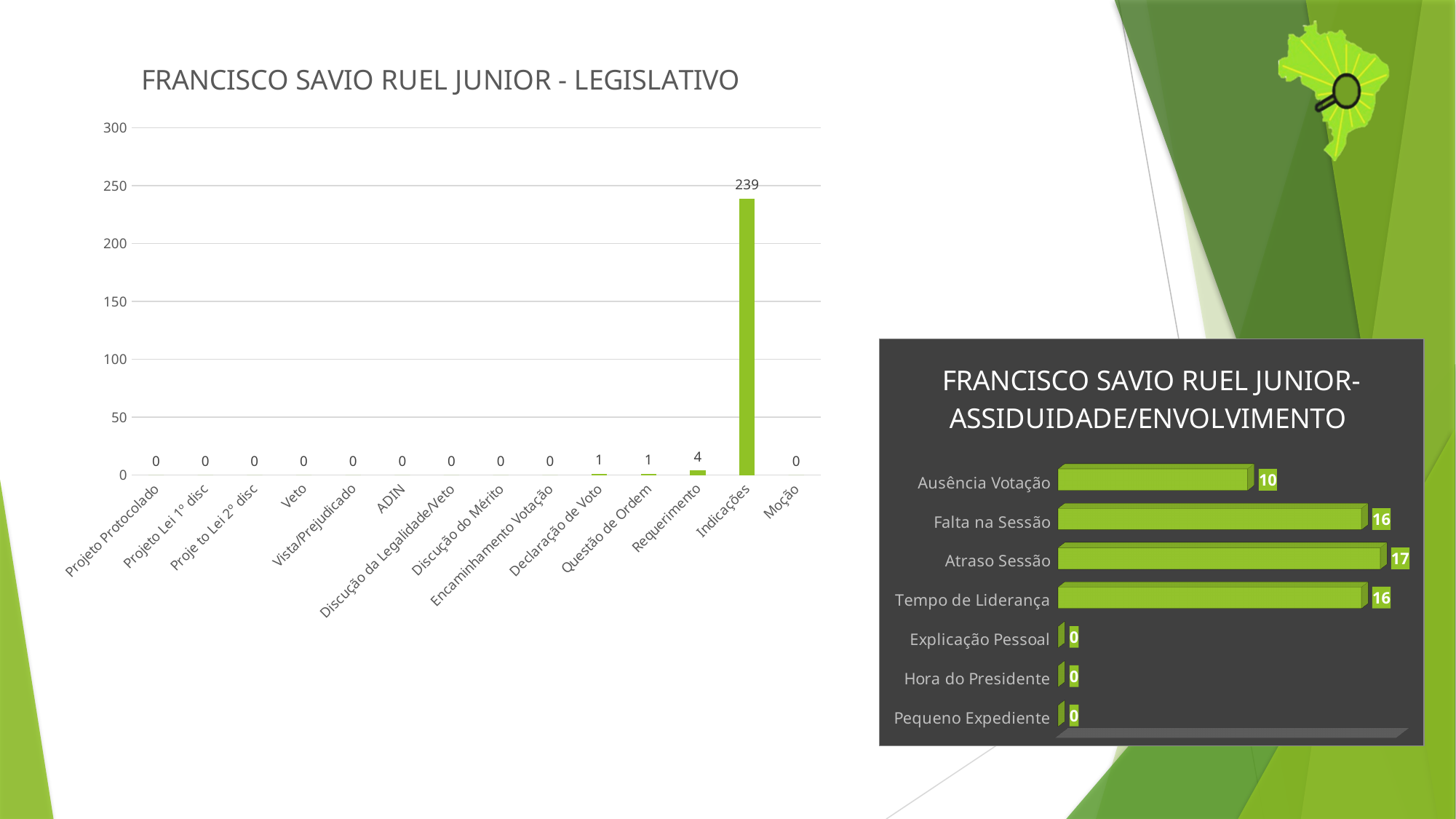
What kind of chart is the ASSIDUIDADE/ENVOLVIMENTO chart? bar chart In the ASSIDUIDADE/ENVOLVIMENTO chart, what is the value for Ausência Votação? 10 In the LEGISLATIVO chart, which category has the highest value? Indicações In the ASSIDUIDADE/ENVOLVIMENTO chart, how many categories are listed? 7 In the LEGISLATIVO chart, what is the value for Requerimento? 4 In the LEGISLATIVO chart, is the value for Indicações greater or less than 200? greater In the ASSIDUIDADE/ENVOLVIMENTO chart, which is larger, Falta na Sessão or Ausência Votação? Falta na Sessão In the LEGISLATIVO chart, what is the difference between Indicações and Requerimento? 235 In the LEGISLATIVO chart, what is the value for Indicações? 239 In the LEGISLATIVO chart, how many categories are shown on the x axis? 14 In the ASSIDUIDADE/ENVOLVIMENTO chart, which category has the highest value? Atraso Sessão In the ASSIDUIDADE/ENVOLVIMENTO chart, what is the difference between Atraso Sessão and Ausência Votação? 7